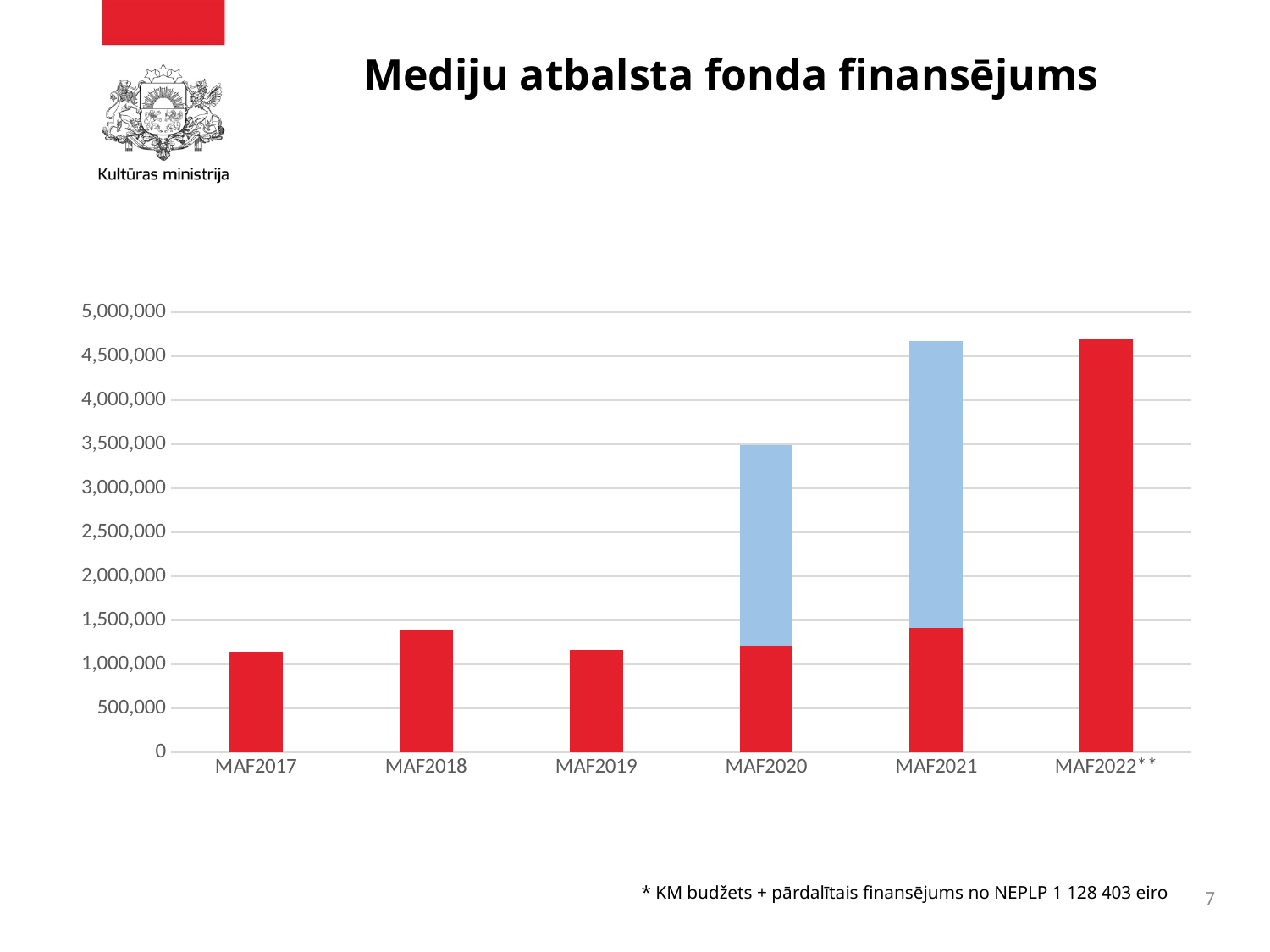
Which has the larger total value, MAF2020 or MAF2018? MAF2020 Is the total value for MAF2017 greater or less than 1,500,000? less What type of chart is shown on the slide? bar chart Which has the larger total value, MAF2021 or MAF2019? MAF2021 Which categories have a blue segment stacked on top of the red bar? MAF2020 and MAF2021 Is the value for MAF2022** greater or less than 4,000,000? greater Is the total value for MAF2021 greater or less than 4,500,000? greater Which has the larger value, MAF2018 or MAF2017? MAF2018 What is the title of the chart? Mediju atbalsta fonda finansējums How many categories are shown on the x axis of the chart? 6